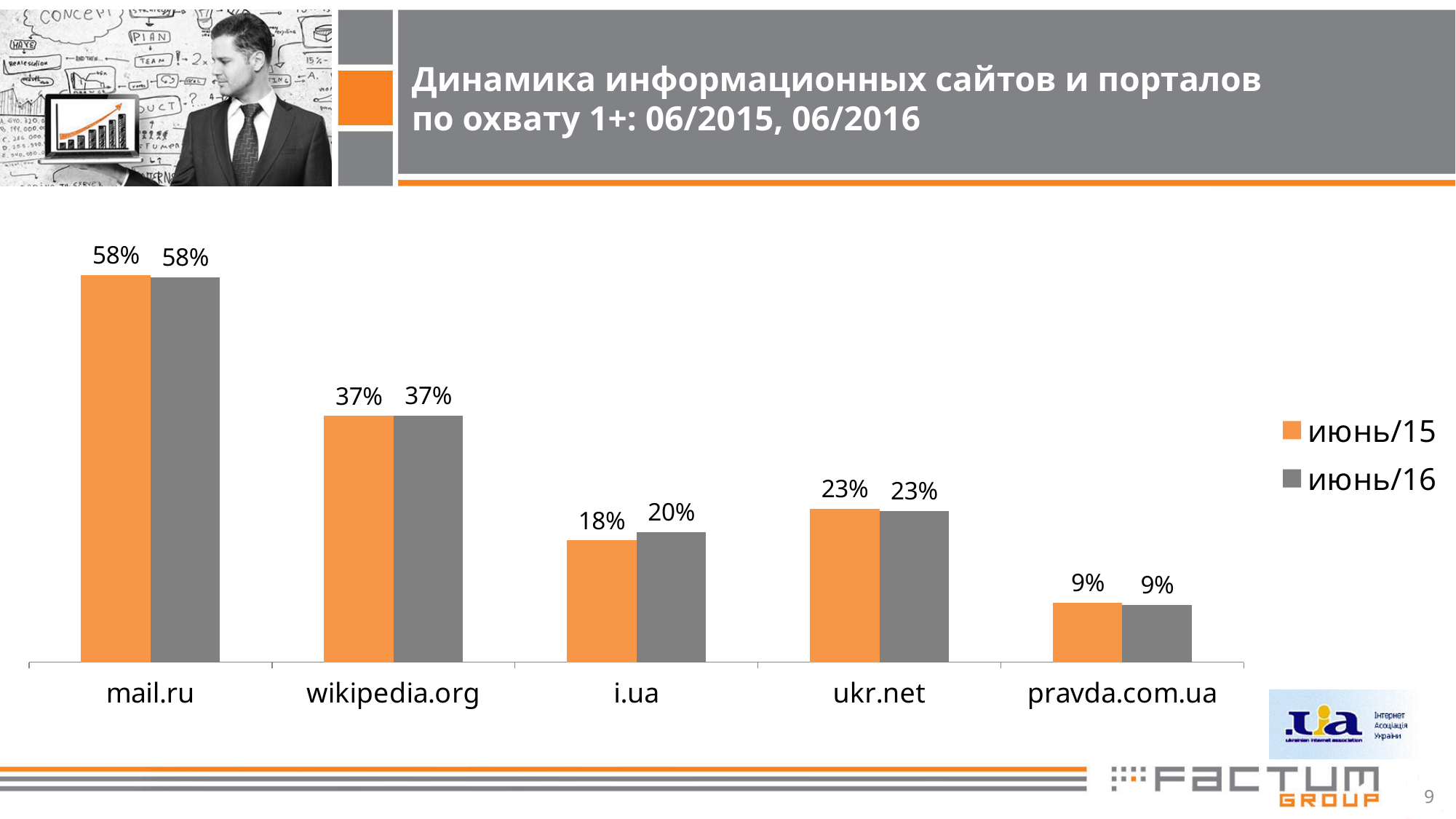
Which is larger: the июнь/16 value for ukr.net or the июнь/16 value for i.ua? ukr.net What is the value for ukr.net in the июнь/16 series? 23% What is the value for pravda.com.ua in the июнь/15 series? 9% What is the value for i.ua in the июнь/15 series? 18% What kind of chart is shown on the slide? bar chart What is the difference between the июнь/16 and июнь/15 values for i.ua? 2% What is the difference between the июнь/15 values for mail.ru and wikipedia.org? 21% How many series does the legend list? 2 Which site has the lowest value in the июнь/15 series? pravda.com.ua How many sites are shown on the x axis? 5 What is the value for mail.ru in the июнь/16 series? 58% Which site has the highest value in the июнь/16 series? mail.ru